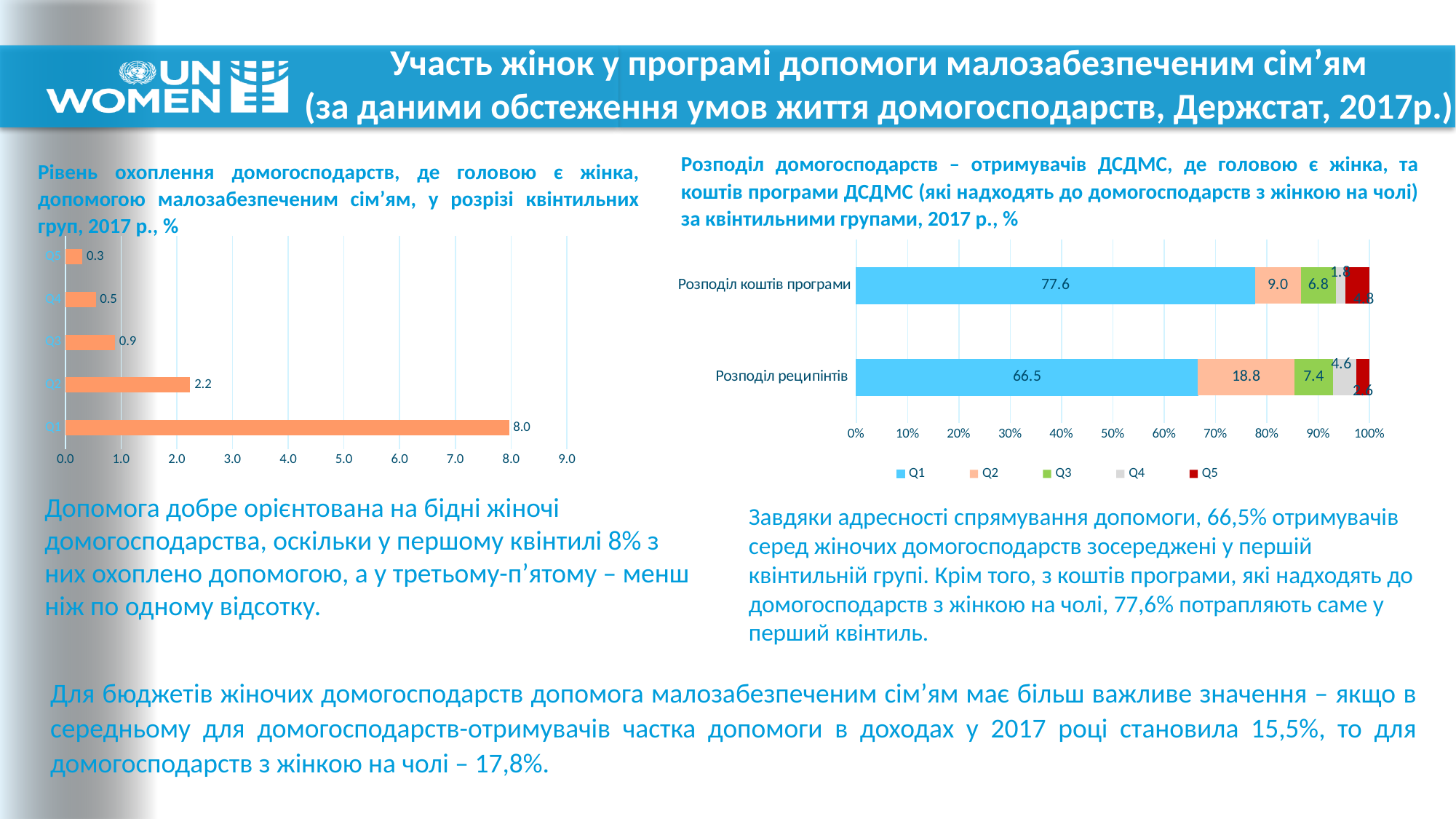
In the right chart (distribution by quintile groups), which bar has the larger Q1 share: 'Розподіл коштів програми' or 'Розподіл реципінтів'? Розподіл коштів програми In the left chart (coverage by quintile group), what kind of chart is shown? Bar chart In the left chart (coverage by quintile group), what is the difference between the values for Q1 and Q2? 5.8 In the right chart (distribution by quintile groups), what is the Q1 value for 'Розподіл коштів програми'? 77.6 In the left chart (coverage by quintile group), which quintile group has the lowest value? Q5 In the left chart (coverage by quintile group), how many quintile groups are plotted? 5 In the right chart (distribution by quintile groups), what is the difference between the Q2 values for 'Розподіл реципінтів' and 'Розподіл коштів програми'? 9.8 In the right chart (distribution by quintile groups), how many series does the legend list? 5 In the right chart (distribution by quintile groups), what is the Q2 value for 'Розподіл реципінтів'? 18.8 In the left chart (coverage by quintile group), what is the value for Q2? 2.2 In the left chart (coverage by quintile group), what is the value for Q1? 8.0 In the right chart (distribution by quintile groups), what colour represents Q5 in the legend? Dark red